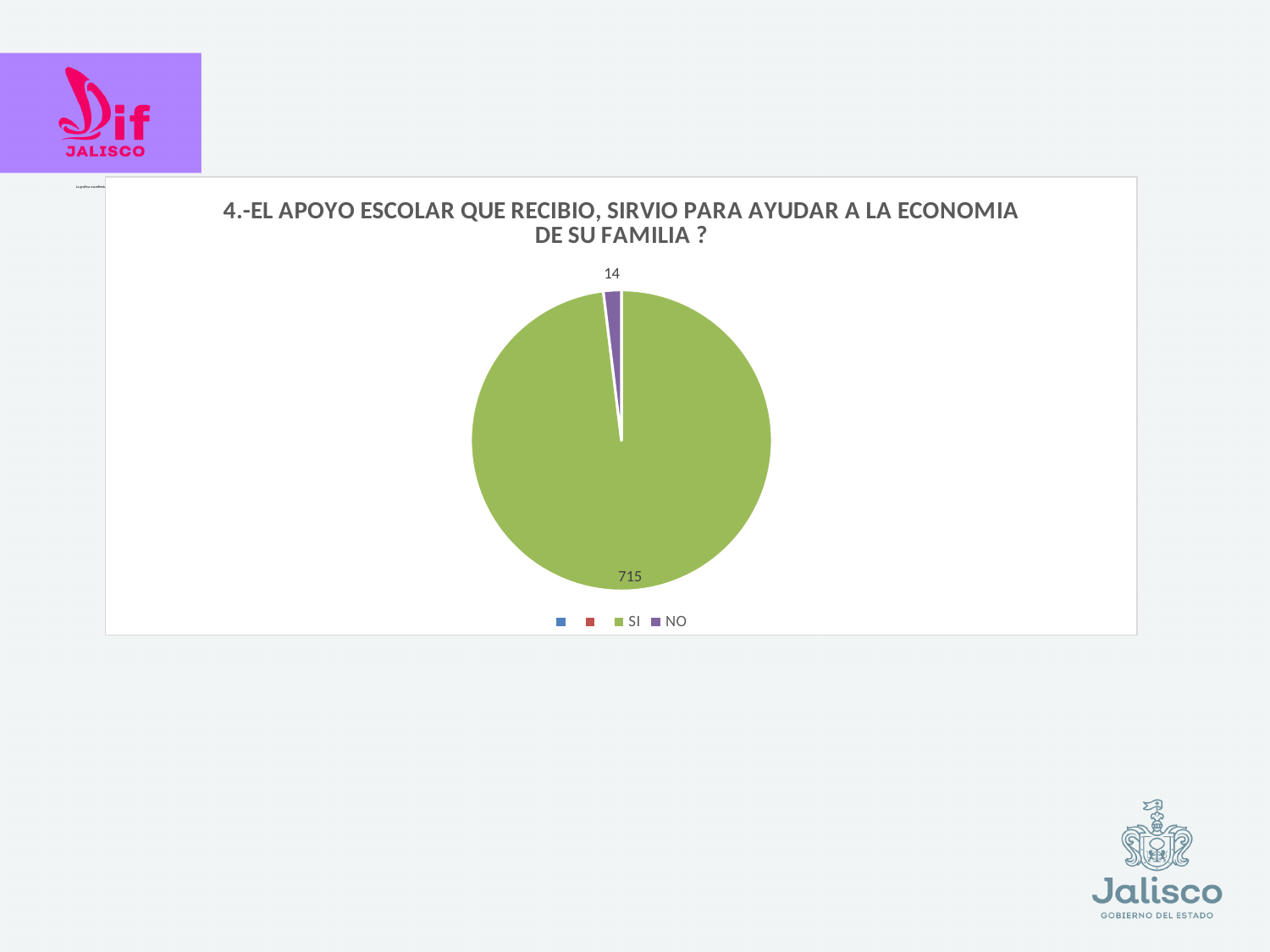
What is the value for NO in the pie chart? 14 Which is larger, the value for SI or the value for NO? SI What is the title of the chart? 4.-EL APOYO ESCOLAR QUE RECIBIO, SIRVIO PARA AYUDAR A LA ECONOMIA DE SU FAMILIA ? What is the value for SI in the pie chart? 715 Which category has the smallest slice in the pie chart? NO How many slices with data labels does the pie chart have? 2 What is the total of the two values shown in the pie chart? 729 What colour is the SI slice in the pie chart? green What type of chart is shown on the slide? pie chart What is the difference between the values for SI and NO? 701 Which category has the largest slice in the pie chart? SI